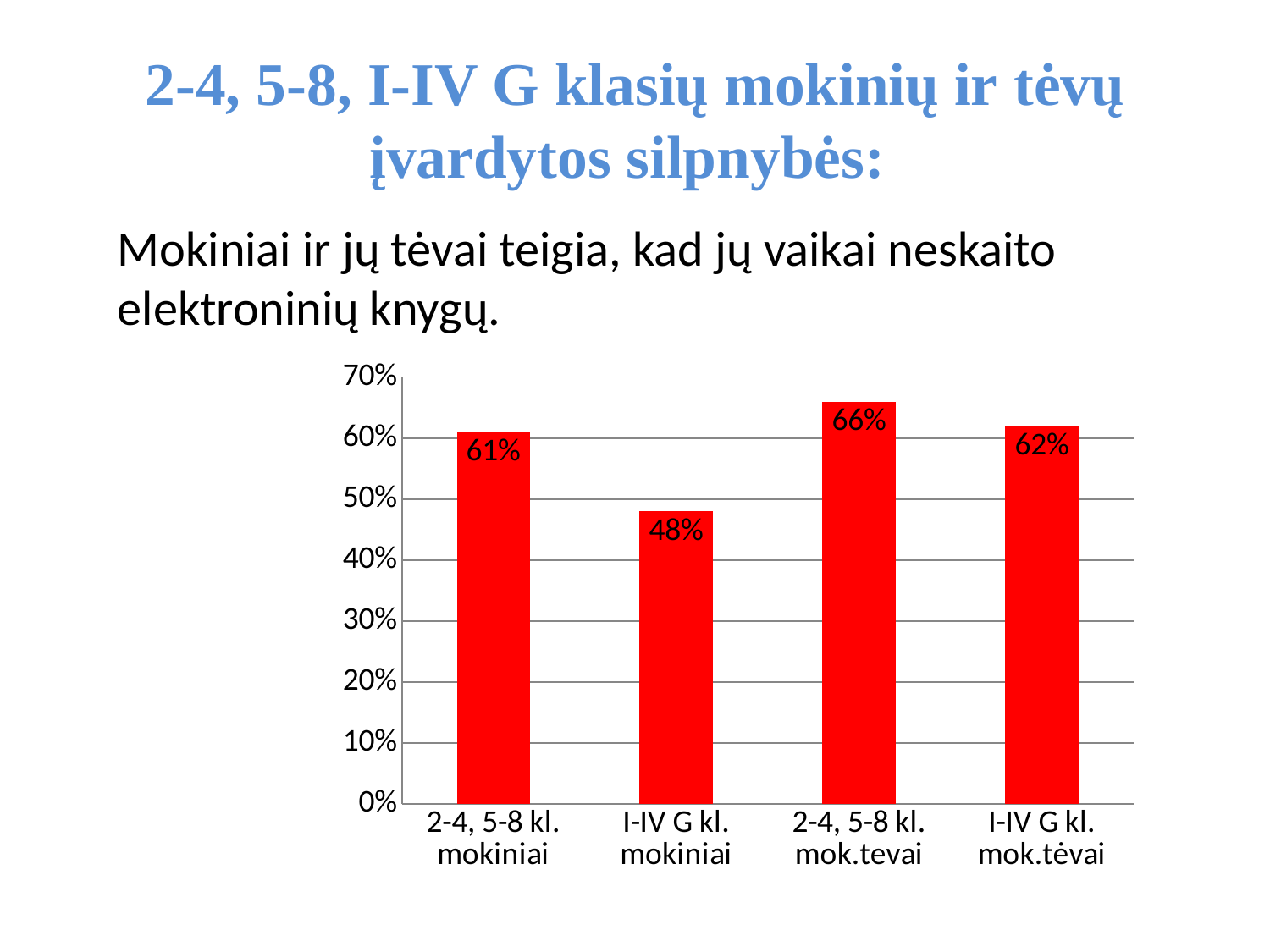
Is the value for "I-IV G kl. mokiniai" greater or less than 50%? less How many categories are shown in the chart? 4 Which category has the highest value? 2-4, 5-8 kl. mok.tevai What is the difference between the values for "2-4, 5-8 kl. mok.tevai" and "I-IV G kl. mokiniai"? 18% What is the value for "2-4, 5-8 kl. mok.tevai"? 66% Which category has the lowest value? I-IV G kl. mokiniai What kind of chart is shown on the slide? bar chart What is the value for "2-4, 5-8 kl. mokiniai"? 61% What is the value for "I-IV G kl. mokiniai"? 48% What colour are the bars in the chart? red What is the value for "I-IV G kl. mok.tėvai"? 62% Which is larger, the value for "2-4, 5-8 kl. mokiniai" or the value for "I-IV G kl. mokiniai"? 2-4, 5-8 kl. mokiniai